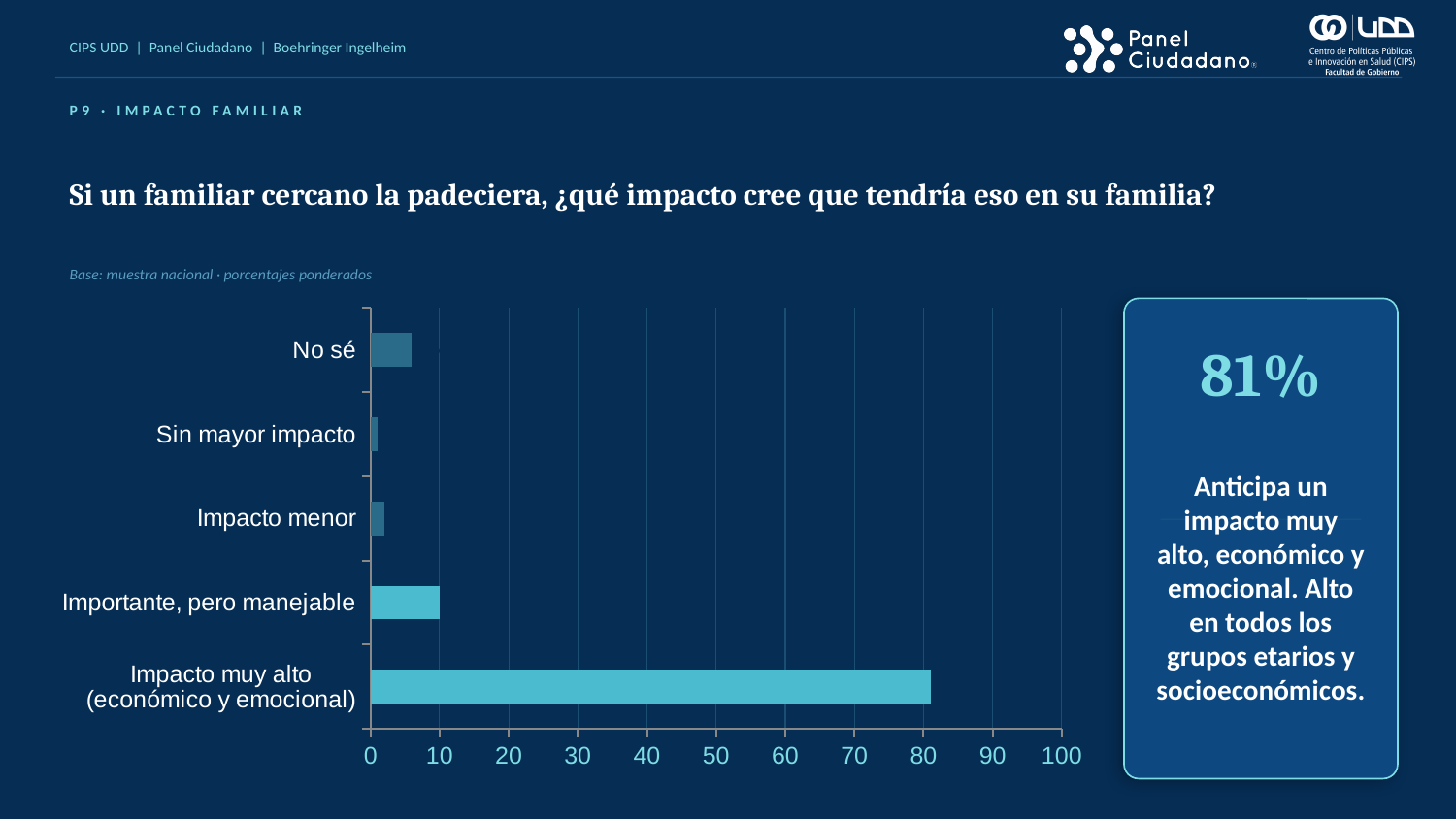
What base is stated for the chart data? Base: muestra nacional · porcentajes ponderados Which is larger, the value for 'Importante, pero manejable' or the value for 'Sin mayor impacto'? Importante, pero manejable Which category has the lowest value in the chart? Sin mayor impacto Is the value for 'Importante, pero manejable' greater or less than 20? less Which category has the highest value in the chart? Impacto muy alto (económico y emocional) Which is larger, the value for 'No sé' or the value for 'Impacto menor'? No sé What percentage of respondents anticipate an 'Impacto muy alto (económico y emocional)'? 81% How many categories are plotted in the chart? 5 What is the maximum value shown on the horizontal axis of the chart? 100 What kind of chart is shown on the slide? Bar chart Is the value for 'Impacto muy alto (económico y emocional)' greater or less than 80? greater Is the value for 'No sé' greater or less than 10? less